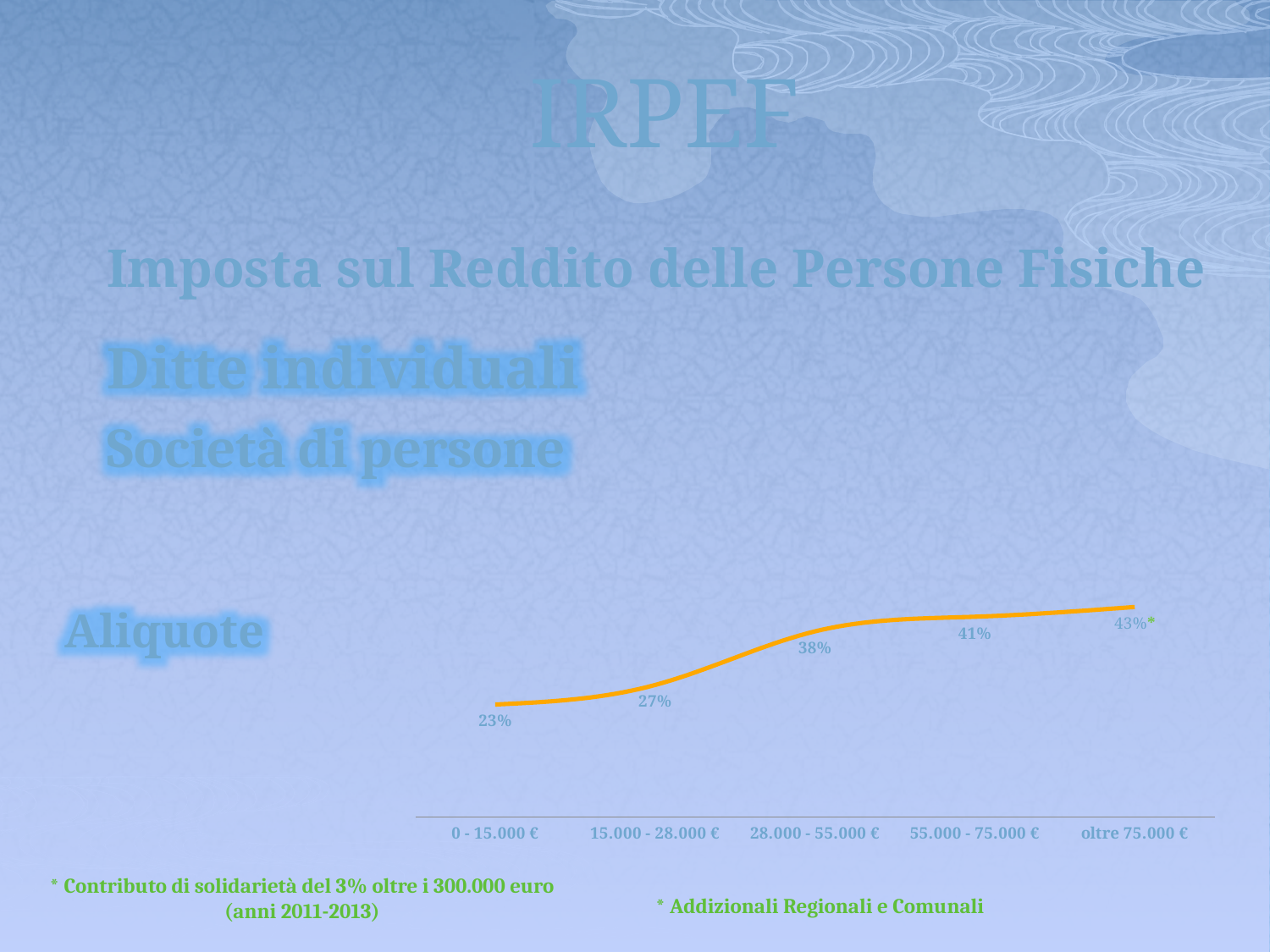
Which income bracket has the highest tax rate on the chart? oltre 75.000 € What is the difference in tax rate between the 28.000 - 55.000 € bracket and the 15.000 - 28.000 € bracket? 11% What kind of chart is used to show the tax rates? Line chart What is the tax rate shown for the 55.000 - 75.000 € income bracket? 41% What colour is the line on the chart? Orange Which income bracket has the lowest tax rate on the chart? 0 - 15.000 € Do the tax rates rise or fall as income brackets increase along the x axis? Rise What is the tax rate shown for the 28.000 - 55.000 € income bracket? 38% Which has a higher tax rate: the 55.000 - 75.000 € bracket or the 28.000 - 55.000 € bracket? 55.000 - 75.000 € What is the tax rate shown for the 15.000 - 28.000 € income bracket? 27% What is the tax rate shown for the 0 - 15.000 € income bracket? 23% How many income brackets are plotted on the chart? 5